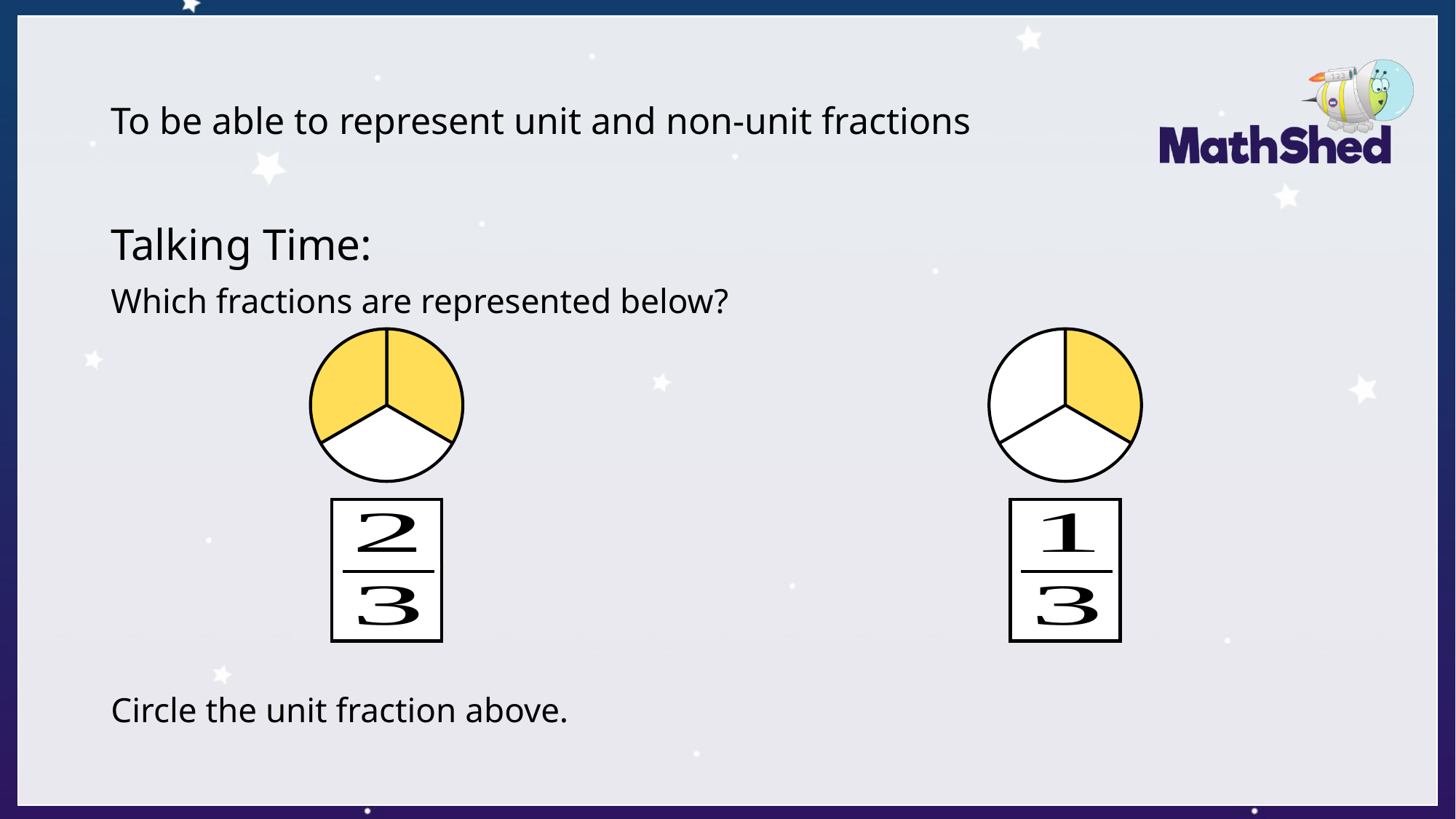
What fraction of the right circle is shaded? 1/3 In the left circle, how many equal parts is the circle divided into? 3 What kind of chart is used to represent the fractions on the slide? pie chart In the right circle, how many equal parts is the circle divided into? 3 Which of the two fractions shown is the unit fraction? 1/3 In the left circle, how many parts are unshaded? 1 Which circle has the larger shaded portion, the left or the right? left What fraction of the left circle is shaded? 2/3 What colour are the shaded parts of the circles? yellow